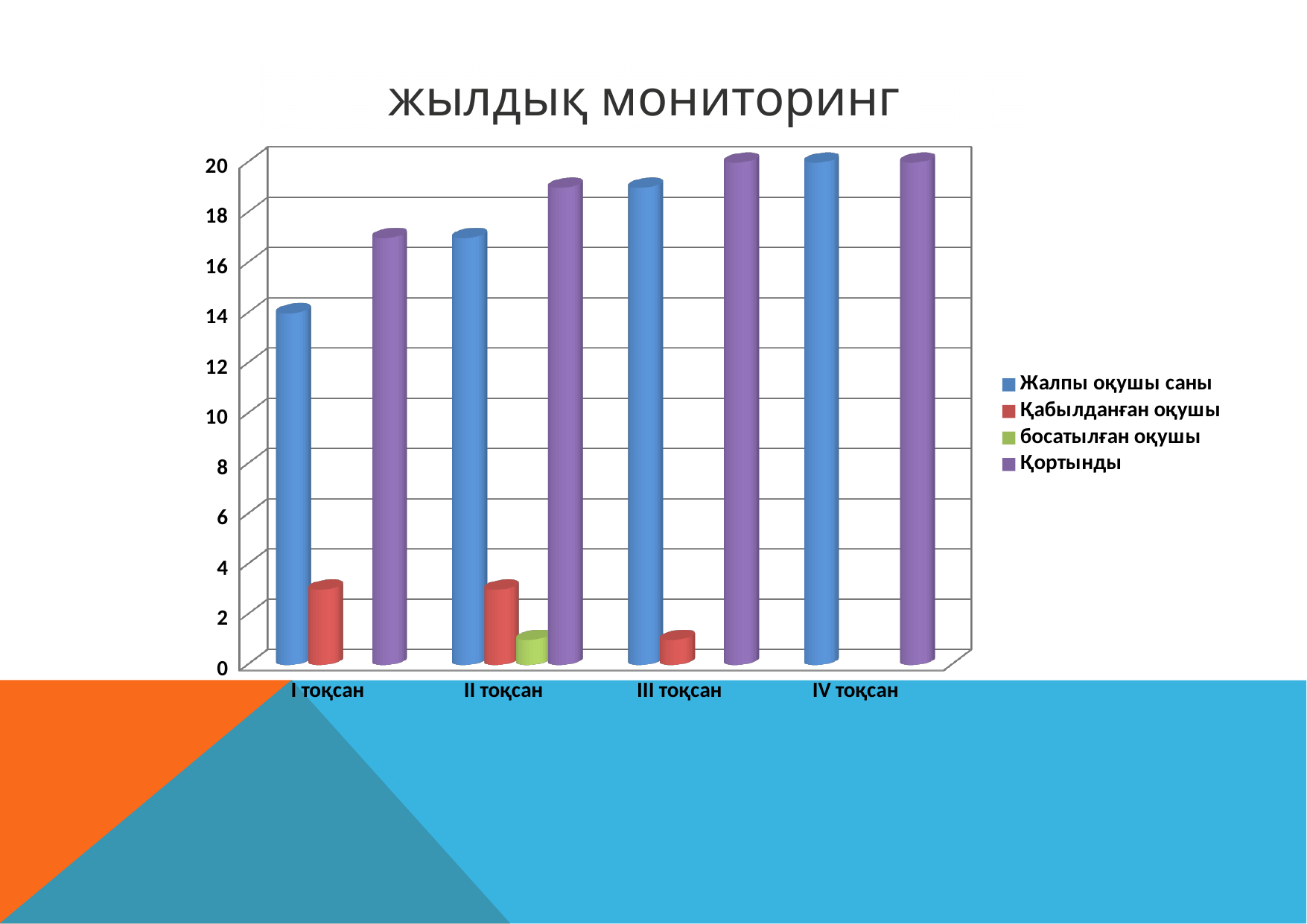
How many categories (quarters) are shown on the x axis? 4 Which is larger, Жалпы оқушы саны for I тоқсан or for II тоқсан? II тоқсан What kind of chart is shown on the slide? bar chart Is the value of Қабылданған оқушы for I тоқсан greater or less than 4? less Does the Жалпы оқушы саны series rise or fall from I тоқсан to IV тоқсан? rise Which quarter has the lowest value of Жалпы оқушы саны? I тоқсан In which quarter does a босатылған оқушы bar appear? II тоқсан Is the value of Қабылданған оқушы for III тоқсан greater or less than 2? less Is the value of Қортынды for II тоқсан greater or less than 18? greater What is the title of the chart? жылдық мониторинг How many series does the legend list? 4